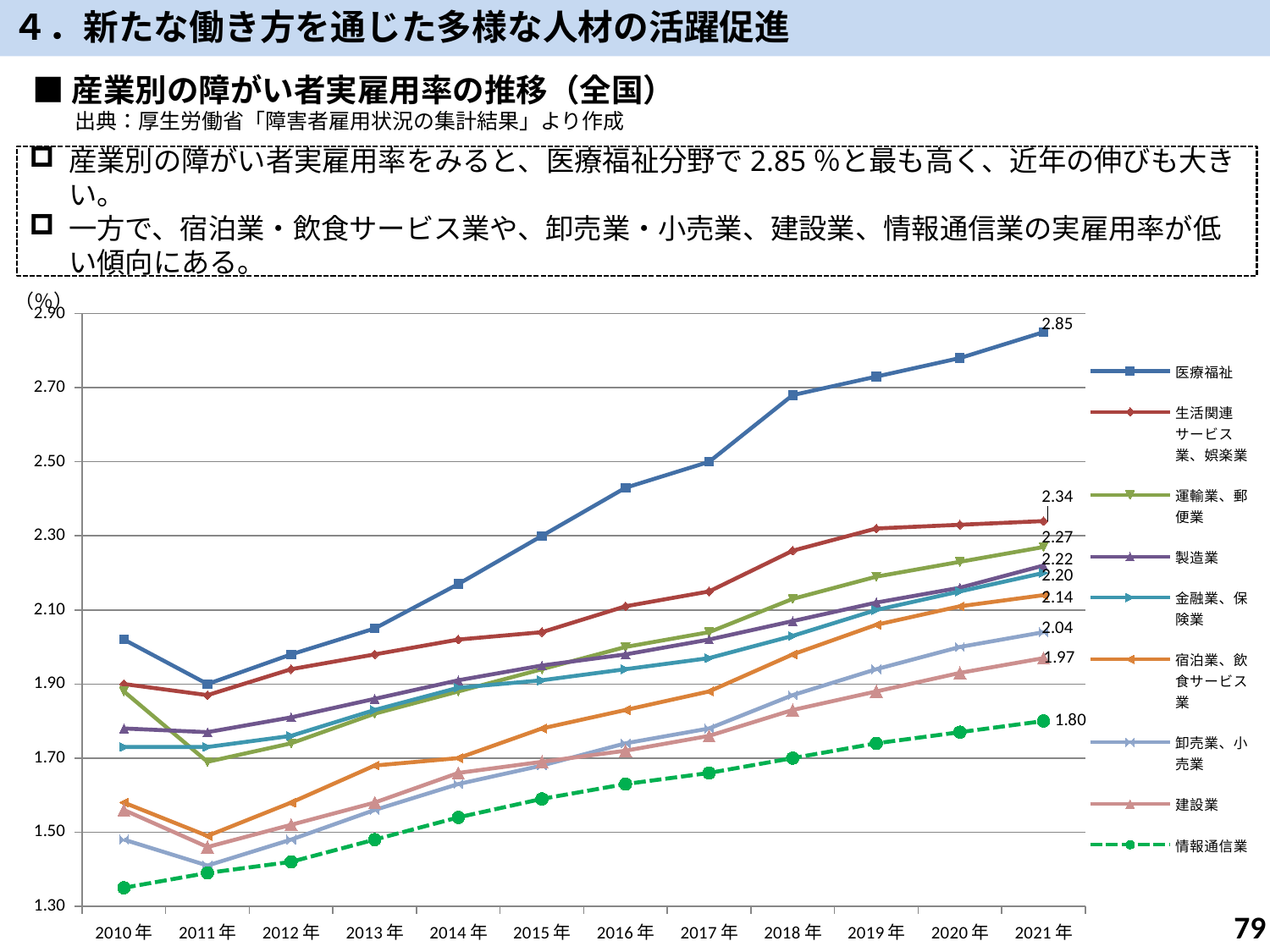
What is the value for 建設業 in 2021年? 1.97 How many years are shown on the x axis? 12 Is the value for 医療福祉 in 2010年 greater or less than 2.10? less What is the difference between the 2021年 values for 医療福祉 and 情報通信業? 1.05 In 2021年, which is larger: 製造業 or 宿泊業、飲食サービス業? 製造業 What is the value for 医療福祉 in 2021年? 2.85 Does the value for 医療福祉 rise or fall from 2011年 to 2021年? rise Which series has the lowest value in 2021年? 情報通信業 What type of chart is shown on the slide? line chart What is the value for 情報通信業 in 2021年? 1.80 Which series has the highest value in 2021年? 医療福祉 How many series does the legend list? 9